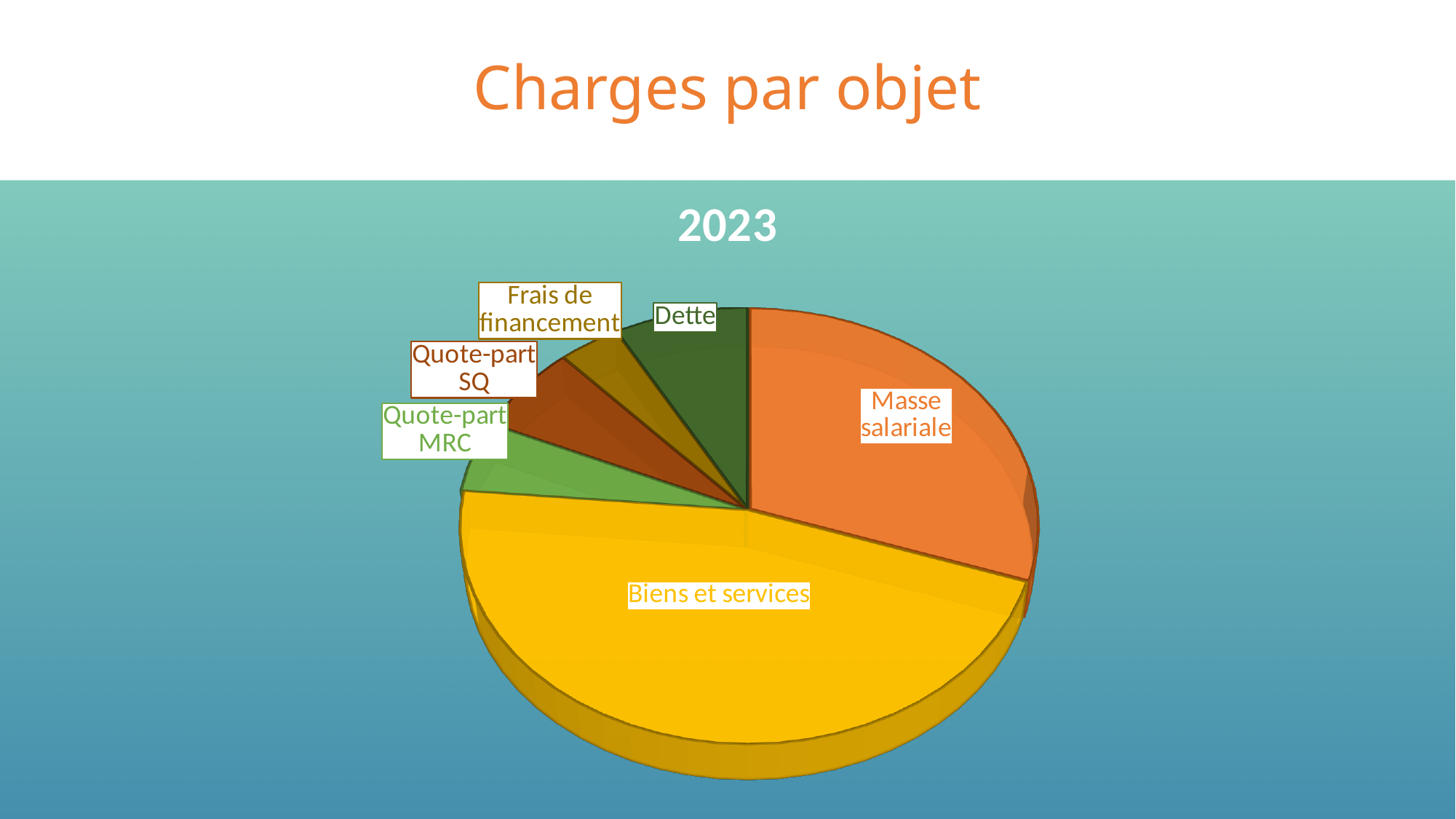
How many slices does the pie chart have? 6 Which slice is larger, Masse salariale or Dette? Masse salariale Which slice is larger, Quote-part MRC or Frais de financement? Quote-part MRC Which category has the largest slice of the pie? Biens et services Which slice is larger, Masse salariale or Quote-part MRC? Masse salariale What year is shown as the chart title? 2023 What kind of chart is shown on the slide? pie chart What is the title of the slide? Charges par objet Which category has the smallest slice of the pie? Frais de financement